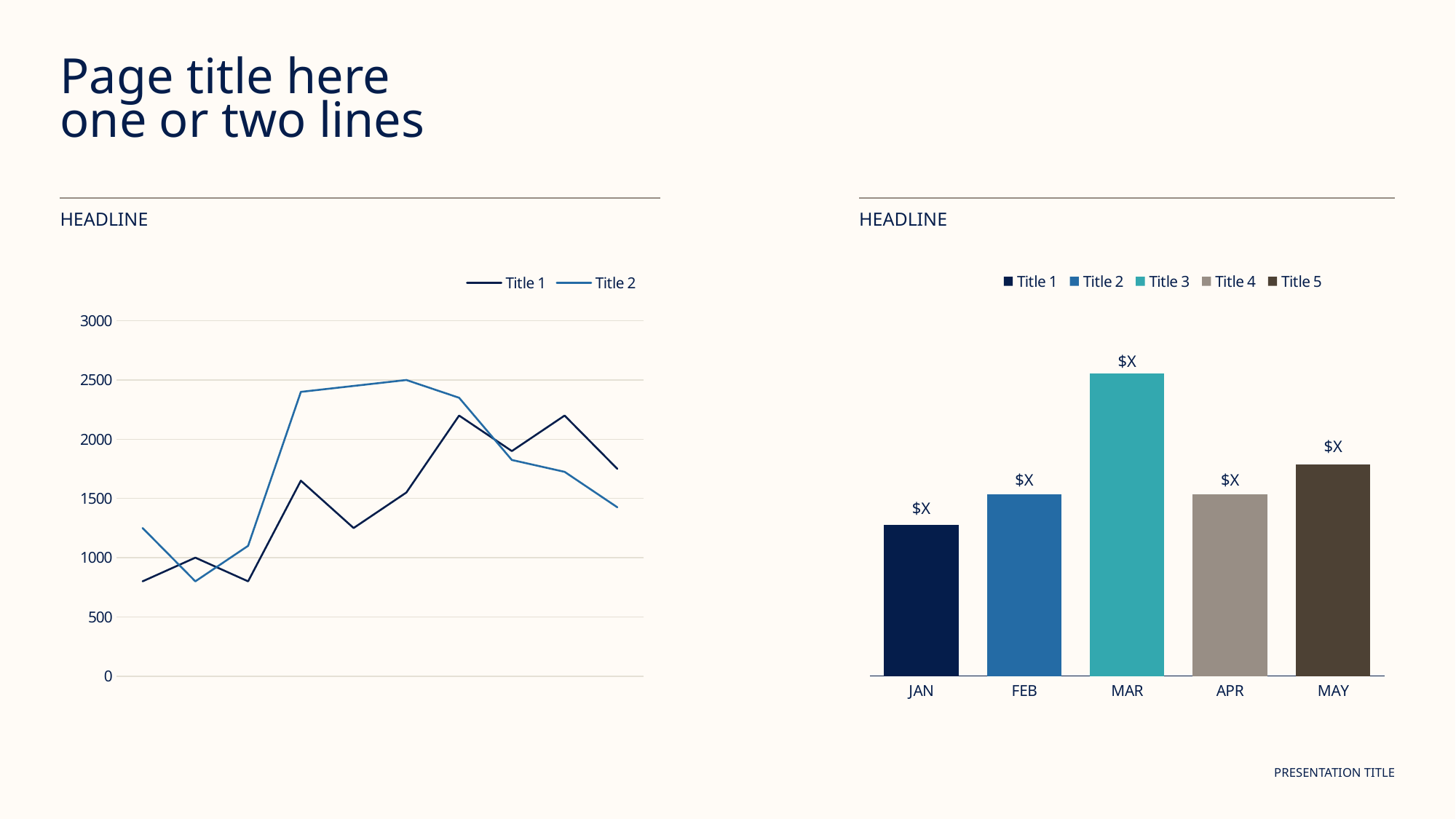
How many series does the legend of the right chart list? 5 In the right chart, what text is shown as the data label above each bar? $X What kind of chart is the chart on the right of the slide? bar chart How many categories are shown on the x axis of the right chart? 5 In the right chart, which bar is taller, MAY or JAN? MAY What kind of chart is the chart on the left of the slide? line chart In the right chart, which month has the shortest bar? JAN In the left chart, is the lowest value of the Title 2 line greater or less than 1000? less In the left chart, is the highest value of the Title 1 line greater or less than 2500? less In the right chart, which month has the tallest bar? MAR In the right chart, which bar is taller, MAR or FEB? MAR How many series does the legend of the left chart list? 2